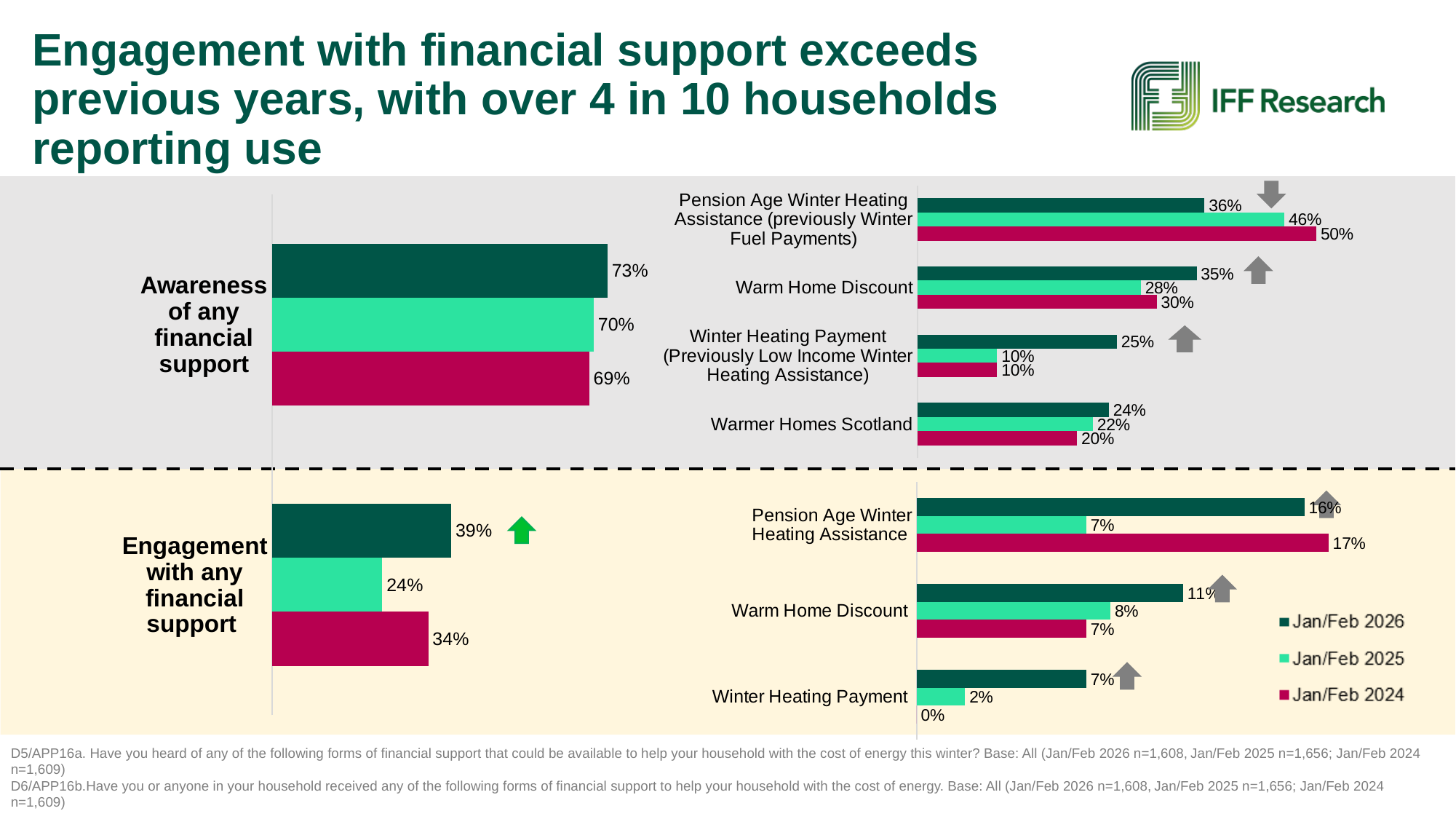
In the 'Engagement with any financial support' chart, which year has the highest value? Jan/Feb 2026 In the 'Awareness of any financial support' chart, what is the value for Jan/Feb 2026? 73% In the 'Engagement with any financial support' chart, which year has the lowest value? Jan/Feb 2025 In the top-right awareness-by-scheme chart, which is larger for Warm Home Discount: the Jan/Feb 2026 value or the Jan/Feb 2025 value? Jan/Feb 2026 In the 'Awareness of any financial support' chart, what is the difference between the Jan/Feb 2026 and Jan/Feb 2024 values? 4 percentage points In the 'Engagement with any financial support' chart, what is the value for Jan/Feb 2025? 24% How many schemes are listed in the top-right awareness-by-scheme chart? 4 In the bottom-right engagement-by-scheme chart, what is the difference between the Jan/Feb 2026 and Jan/Feb 2025 values for Winter Heating Payment? 5 percentage points In the bottom-right engagement-by-scheme chart, what is the Jan/Feb 2026 value for Warm Home Discount? 11% What kind of chart is the 'Awareness of any financial support' chart? Bar chart In the top-right awareness-by-scheme chart, what is the Jan/Feb 2024 value for Pension Age Winter Heating Assistance (previously Winter Fuel Payments)? 50% How many series does the legend list? 3